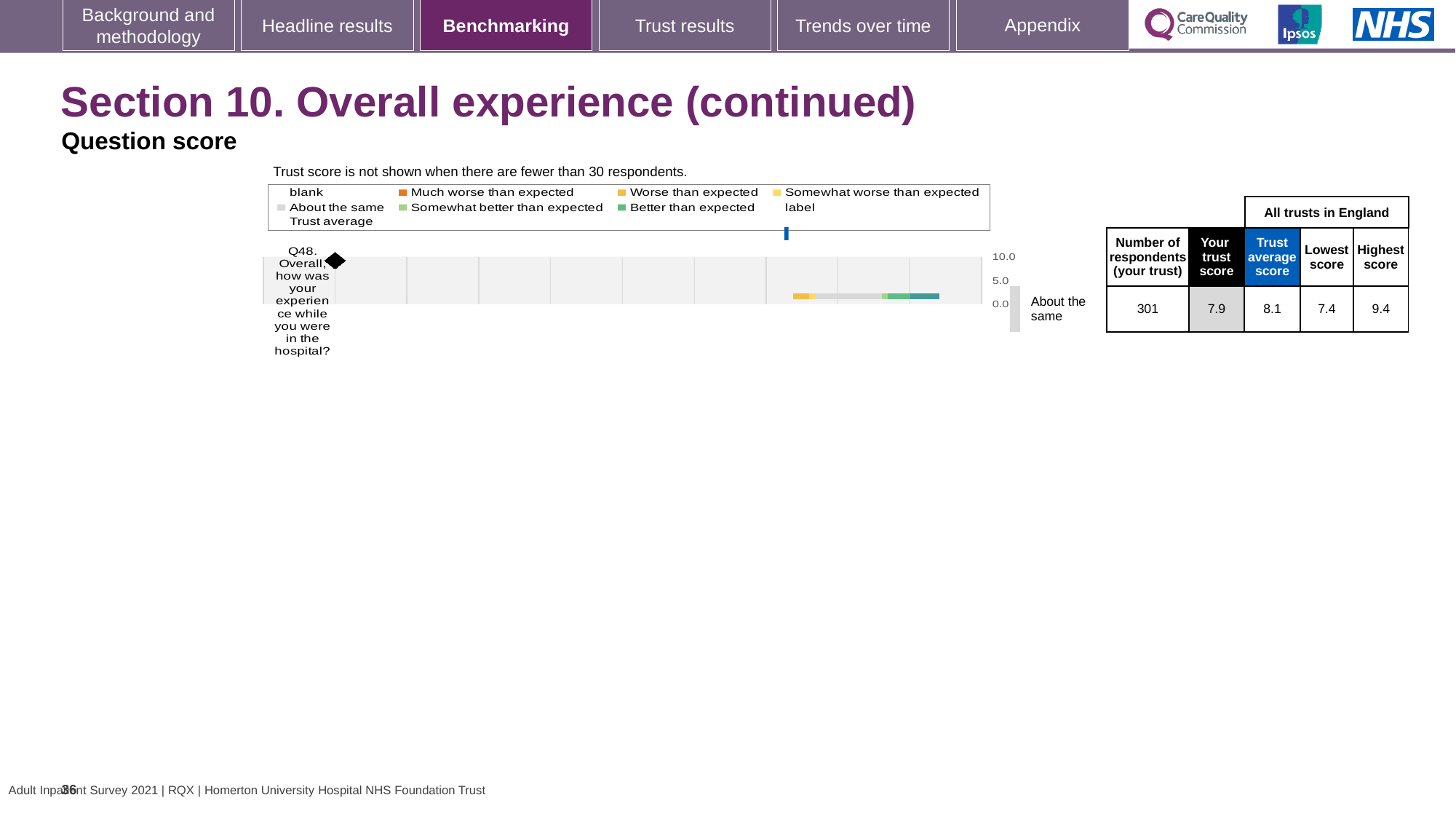
According to the table beside the chart, what is the lowest score among all trusts in England for Q48? 7.4 What is the highest tick value shown on the chart's score axis? 10.0 Which is larger for Q48, the trust score or the trust average score? Trust average score According to the table beside the chart, what is the trust score for Q48? 7.9 How many questions (categories) are plotted in the chart? 1 Which question is plotted in the chart? Q48. Overall, how was your experience while you were in the hospital? According to the table beside the chart, what is the trust average score for Q48? 8.1 What kind of chart is shown on the slide? bar chart What is the difference between the highest score and the lowest score for Q48? 2.0 What benchmark category is the trust's Q48 score labelled as next to the chart? About the same According to the table beside the chart, what is the highest score among all trusts in England for Q48? 9.4 According to the table beside the chart, what is the number of respondents for Q48? 301